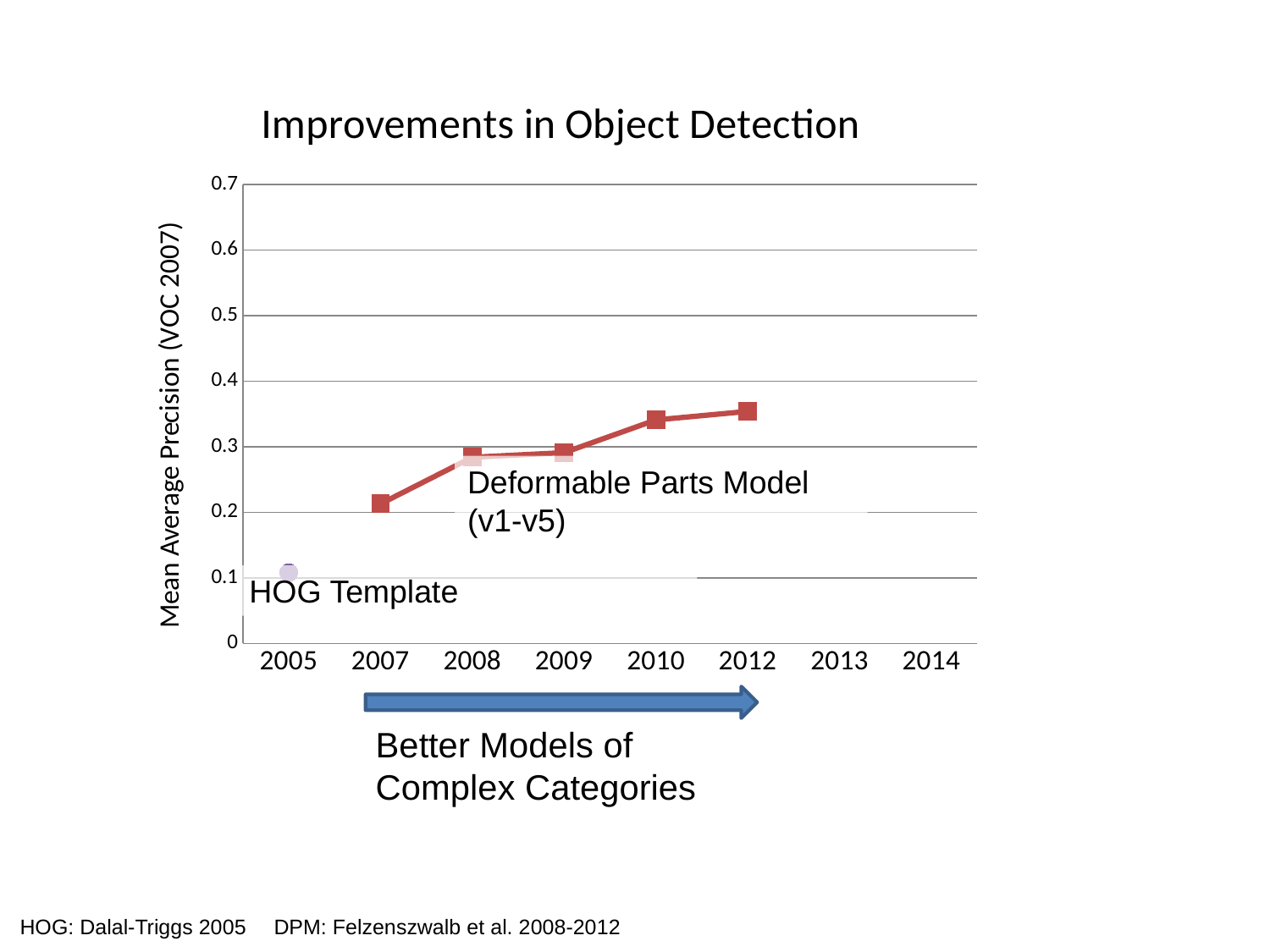
Which is larger, the Deformable Parts Model value for 2010 or for 2007? 2010 In which year does the Deformable Parts Model line reach its highest value? 2012 What kind of chart is shown on the slide? line chart What is the title of the chart? Improvements in Object Detection Does the Deformable Parts Model line rise or fall from 2007 to 2012? rise How many year labels are shown on the x axis? 8 What is the label of the y axis? Mean Average Precision (VOC 2007) Is the Deformable Parts Model value for 2007 greater or less than 0.3? less In which year does the Deformable Parts Model line have its lowest value? 2007 How many data points are plotted on the Deformable Parts Model line? 5 Is the Deformable Parts Model value for 2010 greater or less than 0.3? greater Is the Deformable Parts Model value for 2012 greater or less than 0.4? less